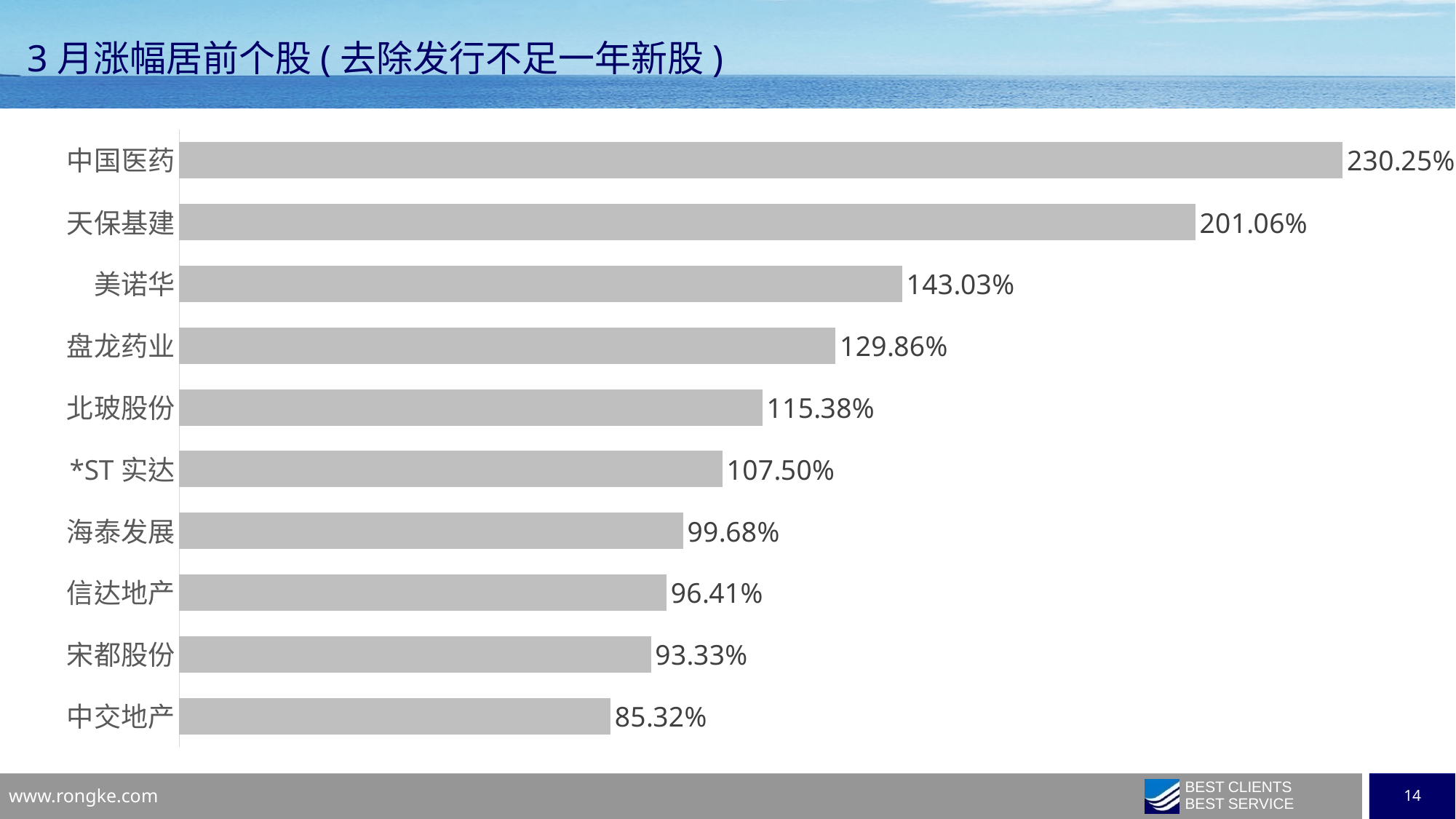
What is the value for 海泰发展? 99.68% What is the difference between the values for 中国医药 and 天保基建? 29.19% How many stocks are shown in the chart? 10 What is the difference between the values for 美诺华 and 盘龙药业? 13.17% What is the value for 盘龙药业? 129.86% What is the title of the slide? 3 月涨幅居前个股 ( 去除发行不足一年新股 ) Which stock has the highest value? 中国医药 What is the value for 中国医药? 230.25% Which is larger, the value for 北玻股份 or the value for *ST 实达? 北玻股份 What kind of chart is shown on the slide? Bar chart Which stock has the lowest value? 中交地产 What is the value for 中交地产? 85.32%